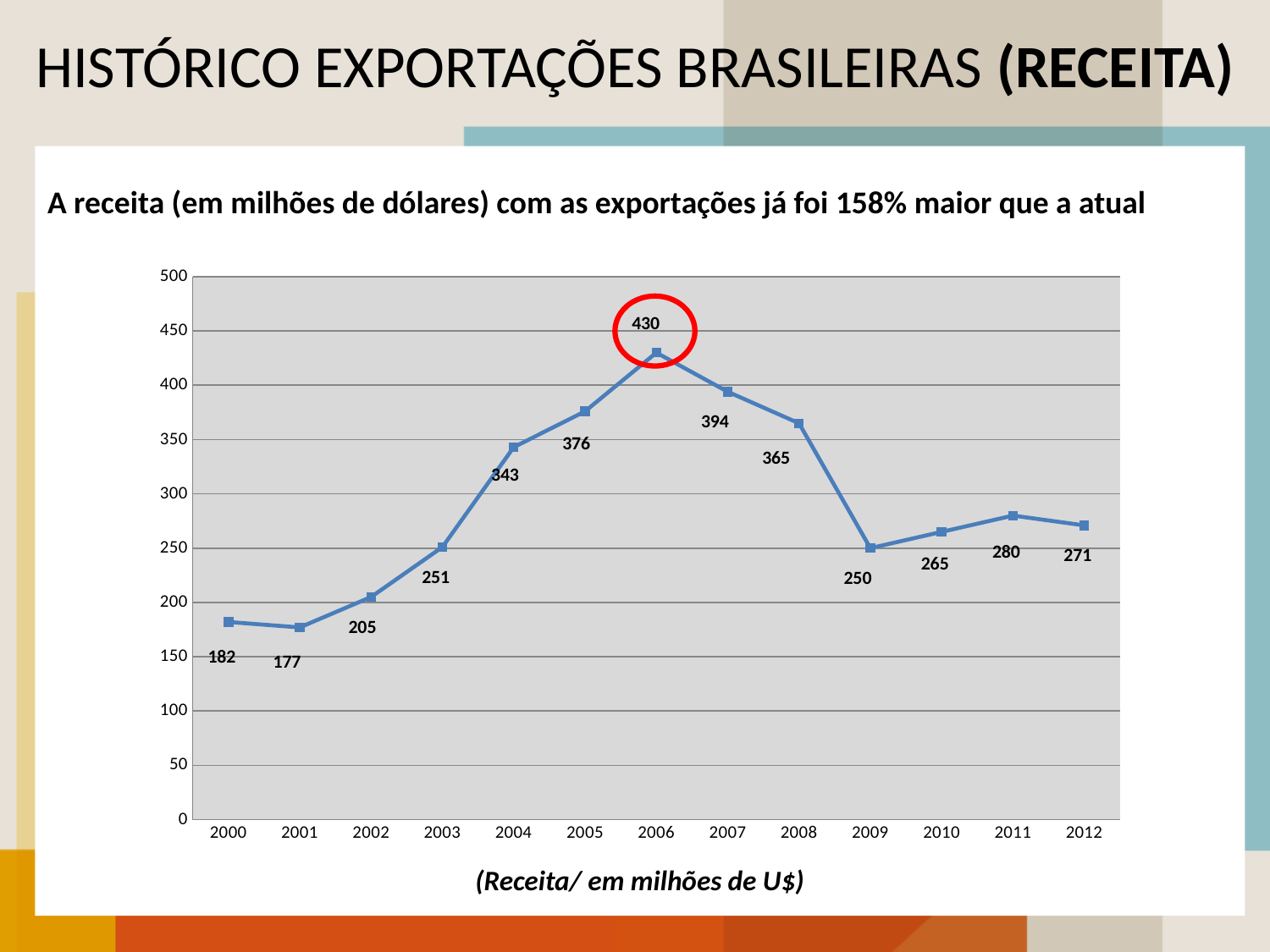
What is the value for 2006? 430 What is the caption shown below the chart? (Receita/ em milhões de U$) Which is larger, the value for 2004 or the value for 2008? 2008 Which year has the lowest value? 2001 What kind of chart is shown? line chart What is the value for 2012? 271 Is the value for 2007 greater or less than 350? greater Which year has the highest value? 2006 Do the values rise or fall from 2001 to 2006? rise What is the difference between the values for 2006 and 2012? 159 How many years are plotted on the x axis? 13 What is the value for 2000? 182